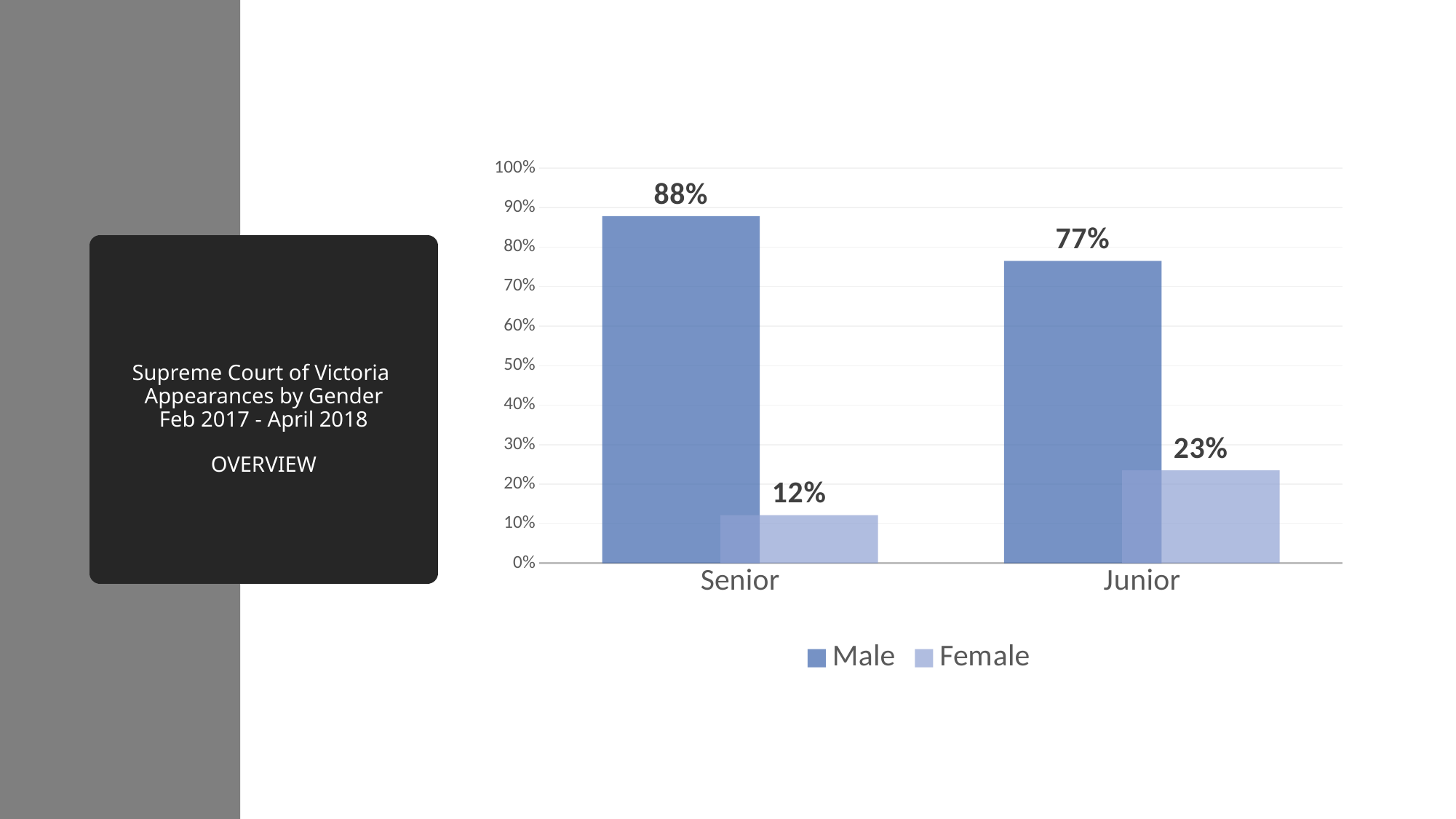
What is the Male value for Senior? 88% What is the Female value for Senior? 12% Which category has the lowest Female value? Senior How many series does the legend list? 2 What is the difference between the Female values for Junior and Senior? 11% How many categories are shown on the x axis? 2 What is the Female value for Junior? 23% What is the difference between the Male and Female values for Senior? 76% Which is larger, the Female value for Junior or the Female value for Senior? Junior What kind of chart is shown on the slide? Bar chart What is the Male value for Junior? 77% Which category has the highest Male value? Senior